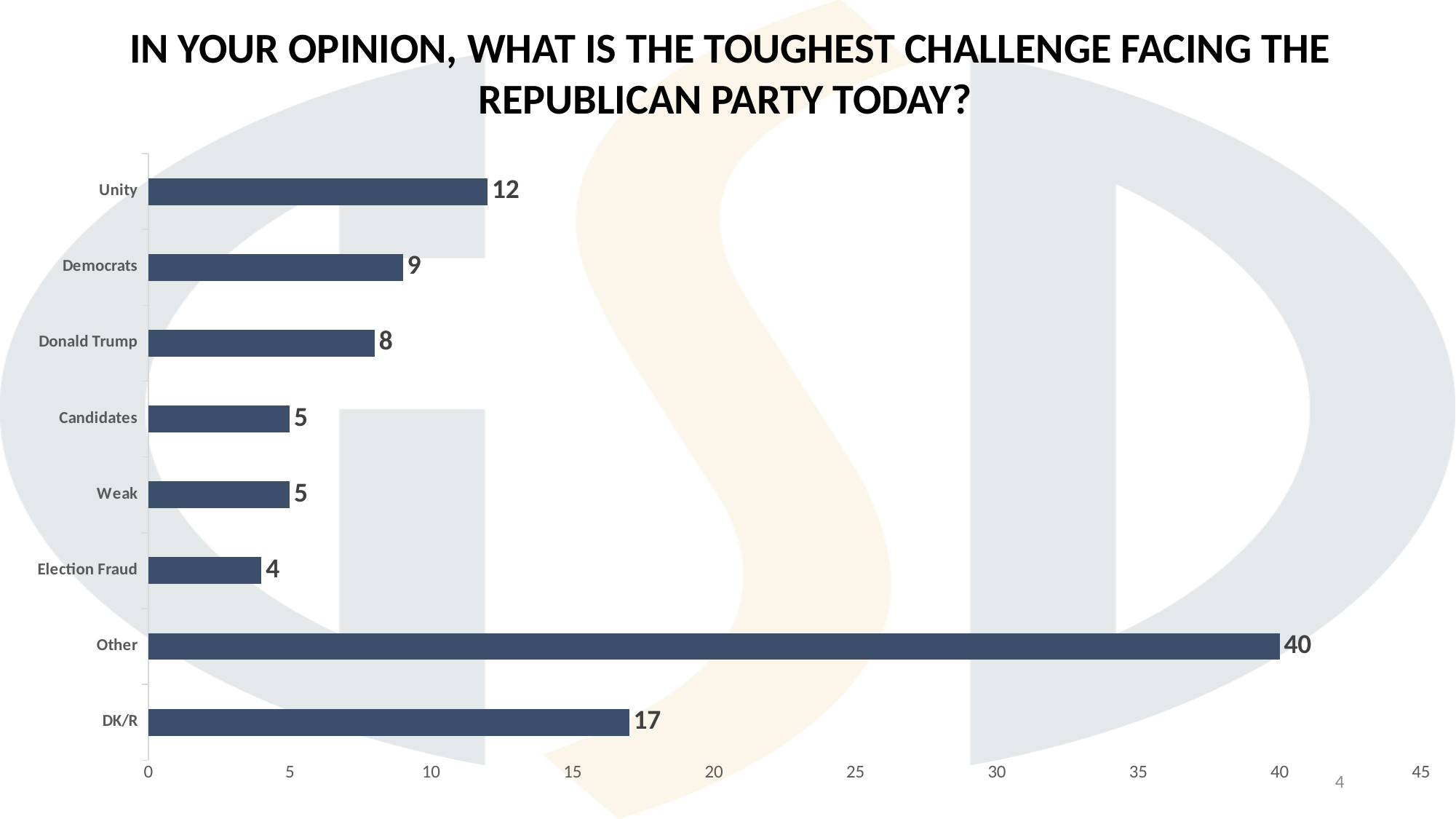
What kind of chart is shown on the slide? Bar chart What is the value for Other? 40 How many categories are shown in the chart? 8 What is the title of the chart? In your opinion, what is the toughest challenge facing the Republican Party today? What is the value for Election Fraud? 4 Which is larger, the value for Democrats or the value for Donald Trump? Democrats Which category has the lowest value? Election Fraud What is the difference between the values for Other and DK/R? 23 What is the difference between the values for Unity and Democrats? 3 What is the value for Unity? 12 Which category has the highest value? Other What is the value for DK/R? 17